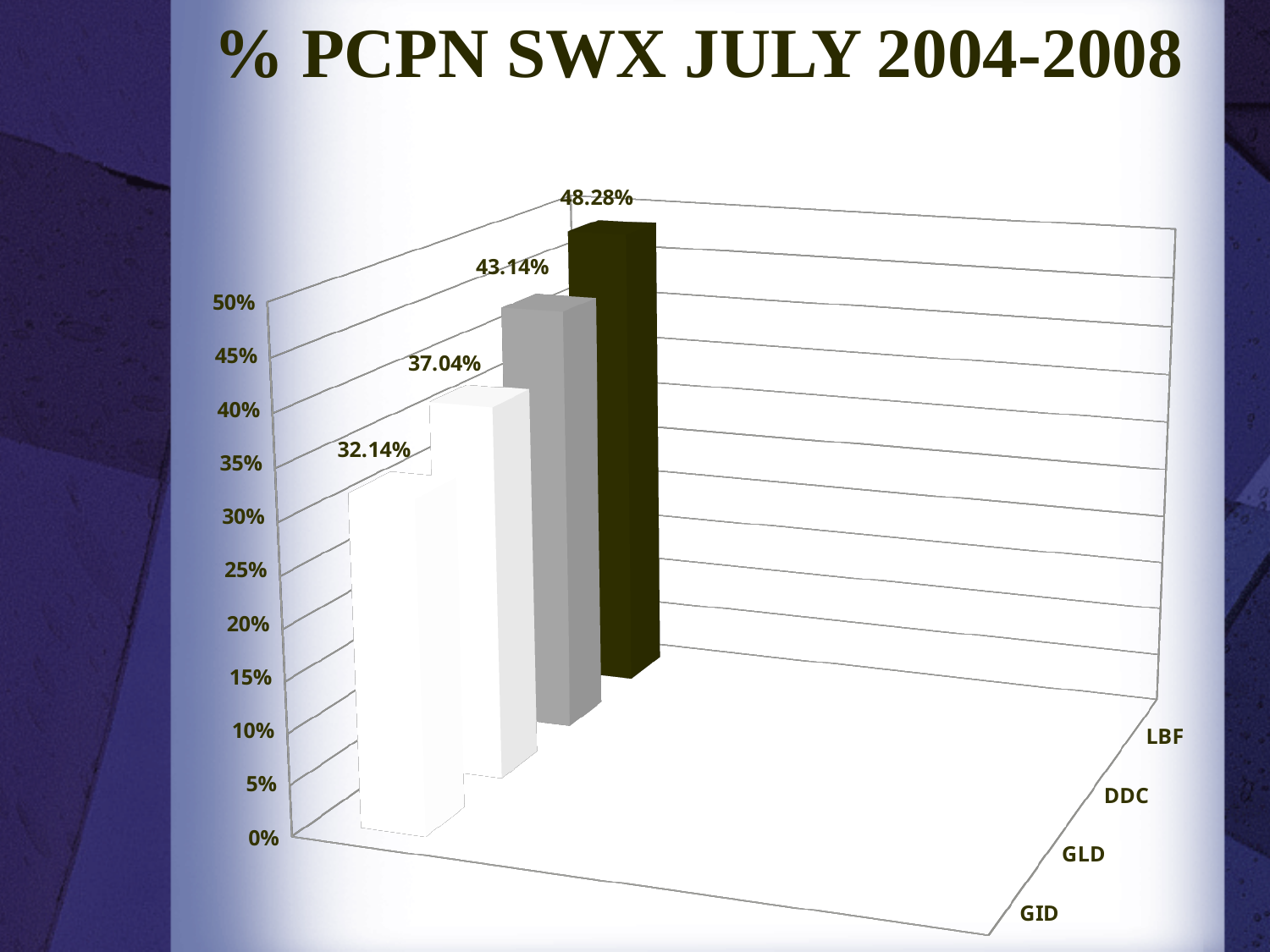
Which category has the lowest value? GID What is the value for LBF? 48.28% How many categories are shown in the chart? 4 What is the value for GLD? 37.04% Which category has the highest value? LBF What kind of chart is shown on the slide? Bar chart What is the difference between the values for LBF and GID? 16.14% What is the title of the chart? % PCPN SWX JULY 2004-2008 What is the value for GID? 32.14% Do the values rise or fall going from GID to LBF? Rise Which is larger, the value for DDC or the value for GLD? DDC What is the value for DDC? 43.14%